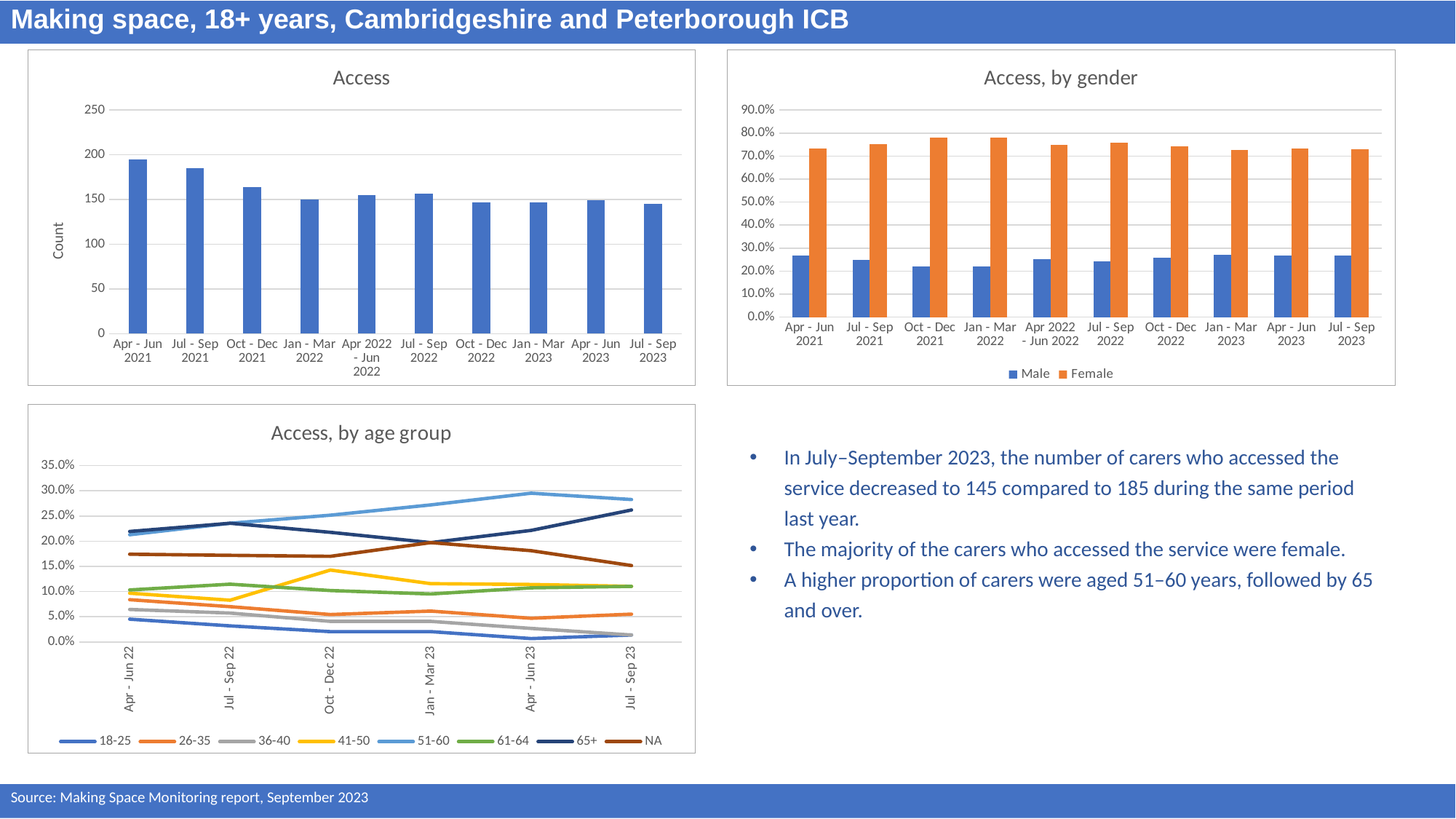
In the "Access" chart, which is larger: the count for Apr - Jun 2021 or the count for Oct - Dec 2021? Apr - Jun 2021 What kind of chart is the "Access, by age group" chart? line chart In the "Access, by age group" chart, which age group has the highest value at Jul - Sep 23? 51-60 How many time periods are shown on the x axis of the "Access" chart? 10 In the "Access" chart, is the count for Jan - Mar 2022 greater or less than 200? less How many series does the legend of the "Access, by gender" chart list? 2 In the "Access" chart, do the counts generally rise or fall from Apr - Jun 2021 to Jul - Sep 2023? fall In the "Access" chart, is the count for Apr - Jun 2021 greater or less than 150? greater In the "Access, by gender" chart, is the Male value for Oct - Dec 2021 greater or less than 30.0%? less In the "Access, by gender" chart, which is larger for Apr - Jun 2021: Male or Female? Female In the "Access" chart, which period has the highest count? Apr - Jun 2021 What kind of chart is the "Access" chart? bar chart